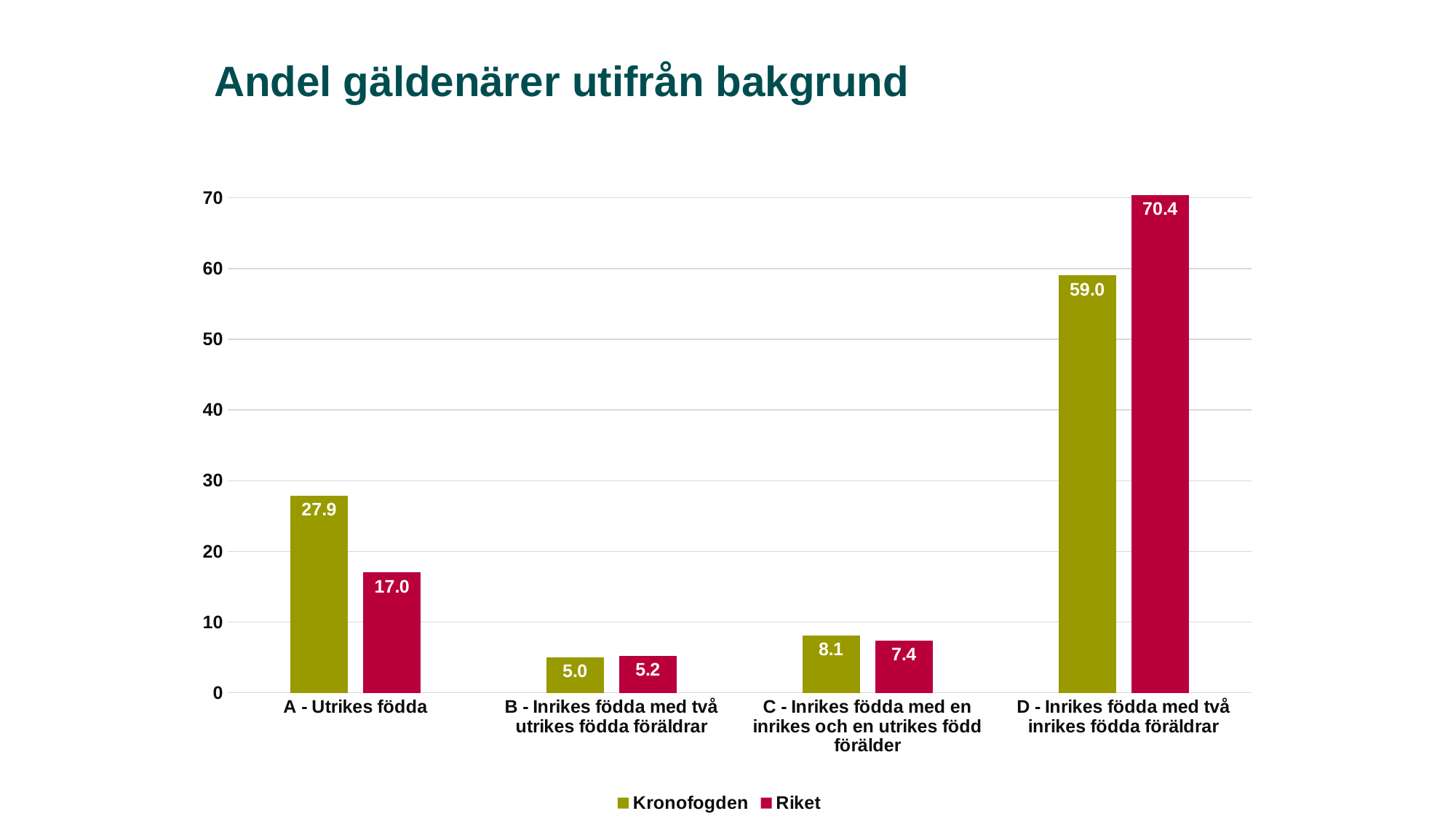
What kind of chart is shown on the slide? Bar chart What is the Riket value for C - Inrikes födda med en inrikes och en utrikes född förälder? 7.4 What is the difference between the Kronofogden and Riket values for A - Utrikes födda? 10.9 What is the difference between the Riket and Kronofogden values for D - Inrikes födda med två inrikes födda föräldrar? 11.4 Which category has the highest Kronofogden value? D - Inrikes födda med två inrikes födda föräldrar Which category has the lowest Riket value? B - Inrikes födda med två utrikes födda föräldrar What is the Riket value for D - Inrikes födda med två inrikes födda föräldrar? 70.4 Is the Kronofogden value for D - Inrikes födda med två inrikes födda föräldrar greater or less than 50? greater For A - Utrikes födda, which series has the larger value, Kronofogden or Riket? Kronofogden What is the Kronofogden value for A - Utrikes födda? 27.9 How many series does the legend list? 2 How many categories are shown on the x axis? 4